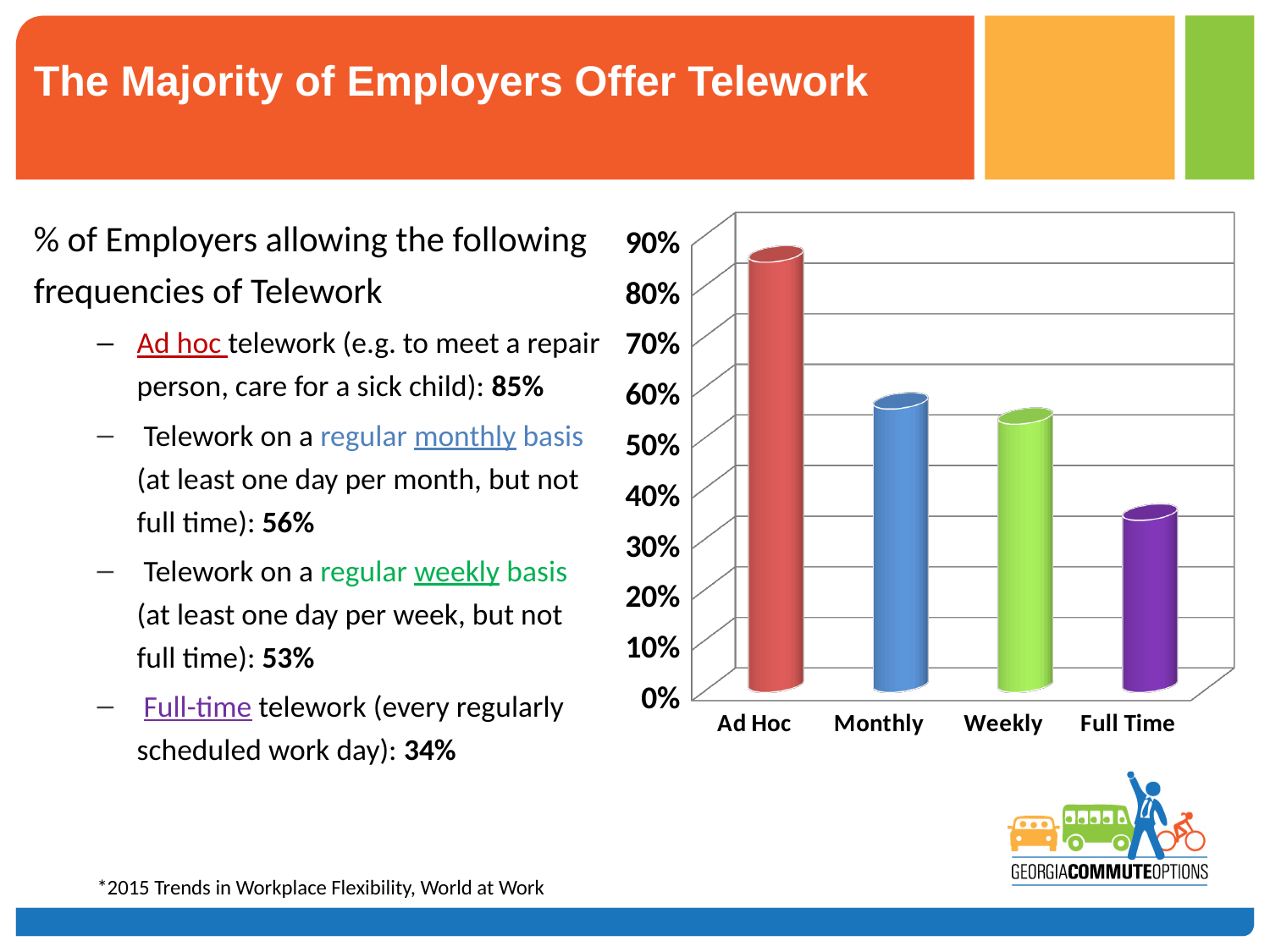
What is the value for Full Time telework? 34% What is the value for Ad Hoc telework? 85% Which category has the lowest bar in the chart? Full Time Is the value for Ad Hoc greater or less than 80%? greater What type of chart is shown on the slide? bar chart Is the value for Weekly greater or less than 50%? greater How many categories are shown on the x axis of the chart? 4 What is the difference between the Ad Hoc value and the Full Time value? 51% Which is larger, the value for Ad Hoc or the value for Full Time? Ad Hoc What is the value for Monthly telework? 56% Which category has the highest bar in the chart? Ad Hoc Is the value for Full Time greater or less than 40%? less